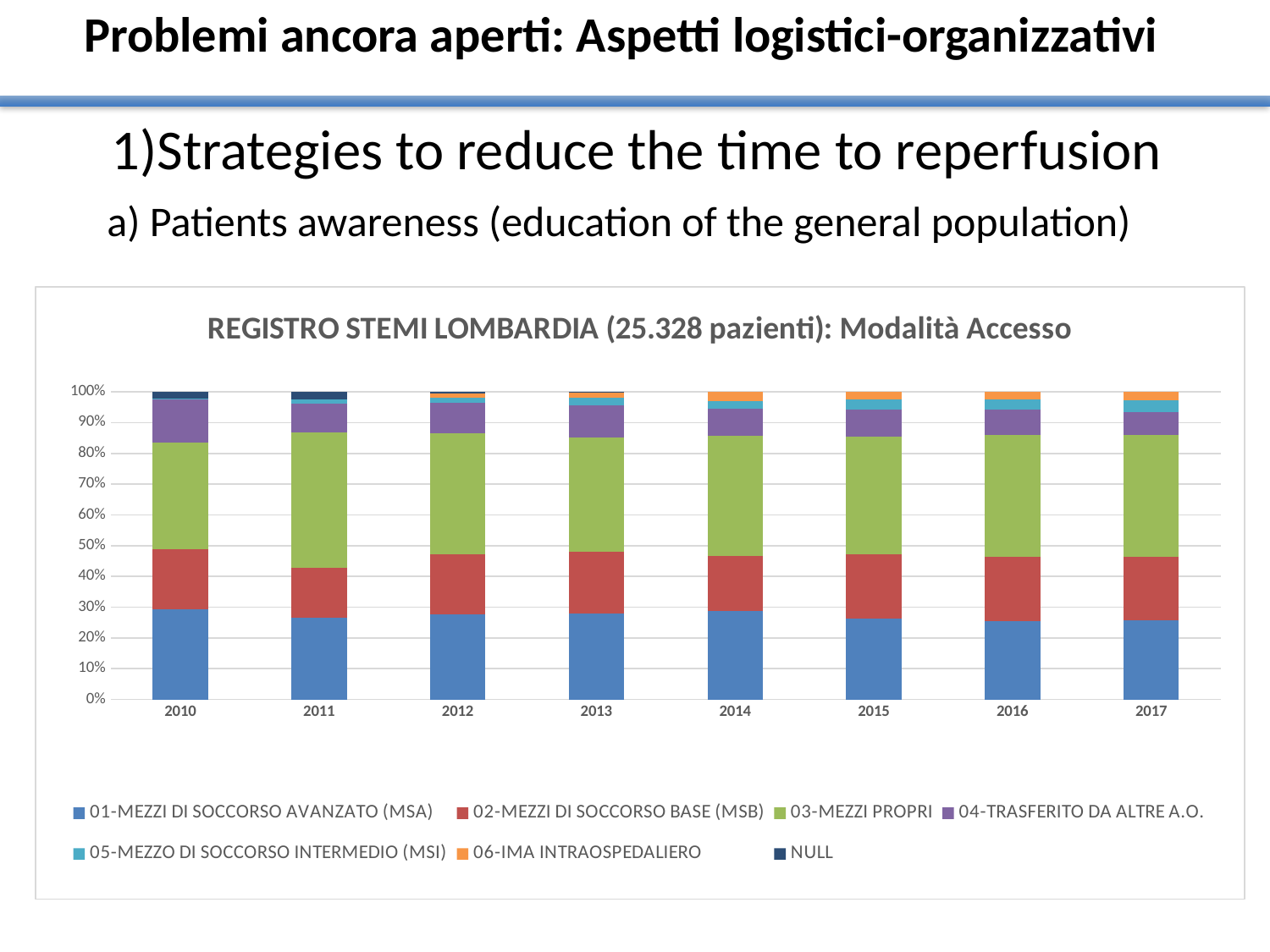
What is the title of the chart? REGISTRO STEMI LOMBARDIA (25.328 pazienti): Modalità Accesso In 2011, which is larger: the share of 01-MEZZI DI SOCCORSO AVANZATO (MSA) or 02-MEZZI DI SOCCORSO BASE (MSB)? 01-MEZZI DI SOCCORSO AVANZATO (MSA) Does the share of 01-MEZZI DI SOCCORSO AVANZATO (MSA) rise or fall from 2010 to 2017? fall Is the share of 01-MEZZI DI SOCCORSO AVANZATO (MSA) in 2017 greater or less than 30%? less How many series does the chart legend list? 7 Which year is the first category on the x axis? 2010 Is the combined share of MSA and MSB in 2011 greater or less than 50%? less Which access mode has the largest share in 2010? 03-MEZZI PROPRI How many years are shown on the x axis of the chart? 8 What kind of chart is shown on the slide? Stacked bar chart Is the share of NULL in 2010 greater or less than 10%? less